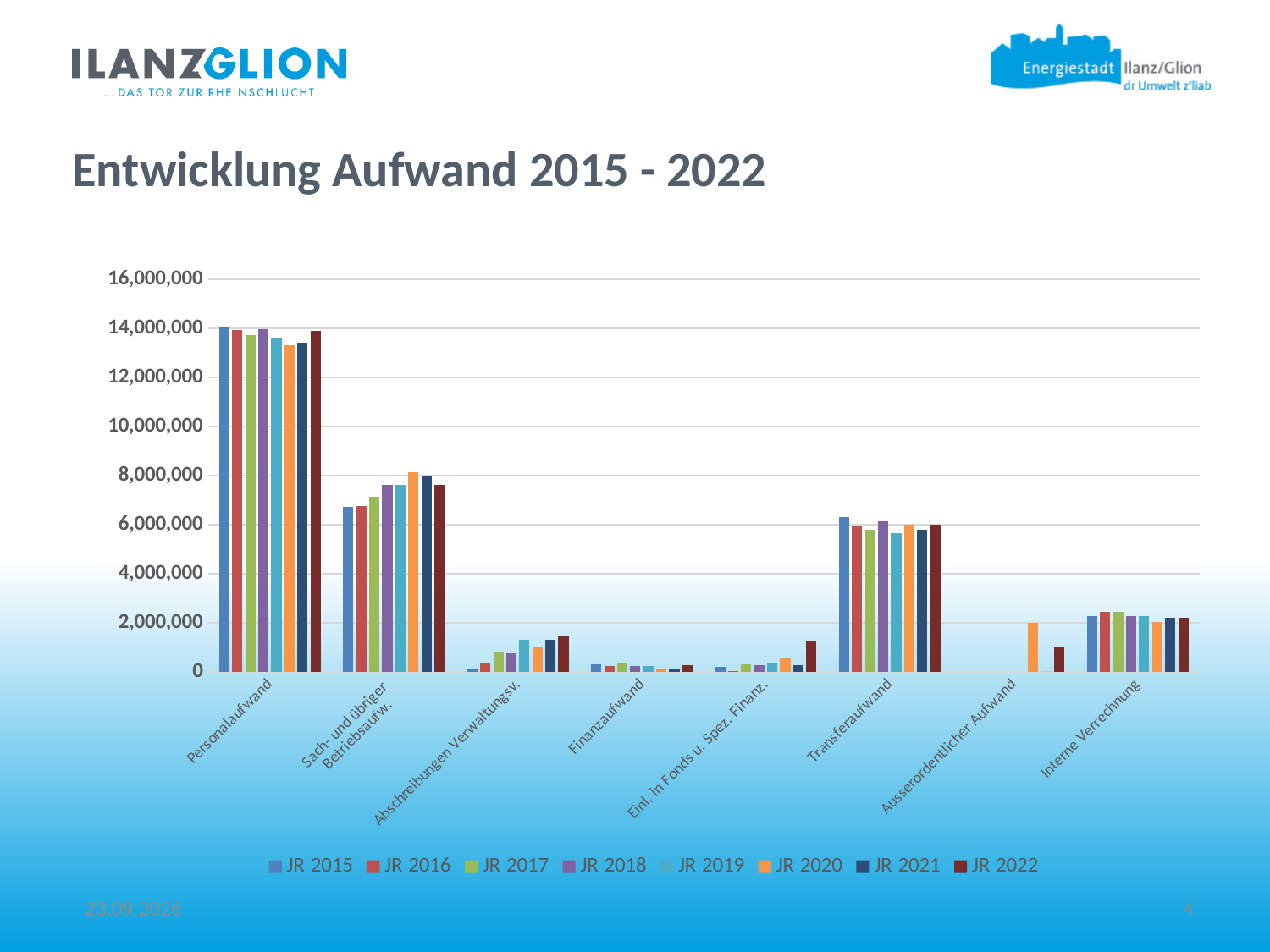
Is the value for Transferaufwand in JR 2015 greater or less than 4,000,000? greater Is the value for Sach- und übriger Betriebsaufw. in JR 2020 greater or less than 6,000,000? greater How many expense categories are shown on the x axis? 8 What is the title of the chart on the slide? Entwicklung Aufwand 2015 - 2022 Is the value for Abschreibungen Verwaltungsv. in JR 2022 greater or less than 2,000,000? less What kind of chart is shown on the slide? Bar chart For JR 2022, which is larger: Personalaufwand or Transferaufwand? Personalaufwand How many series does the legend list? 8 Which years show a visible bar for Ausserordentlicher Aufwand? JR 2020 and JR 2022 For JR 2018, which is larger: Sach- und übriger Betriebsaufw. or Abschreibungen Verwaltungsv.? Sach- und übriger Betriebsaufw. Which category has the highest values across all years? Personalaufwand